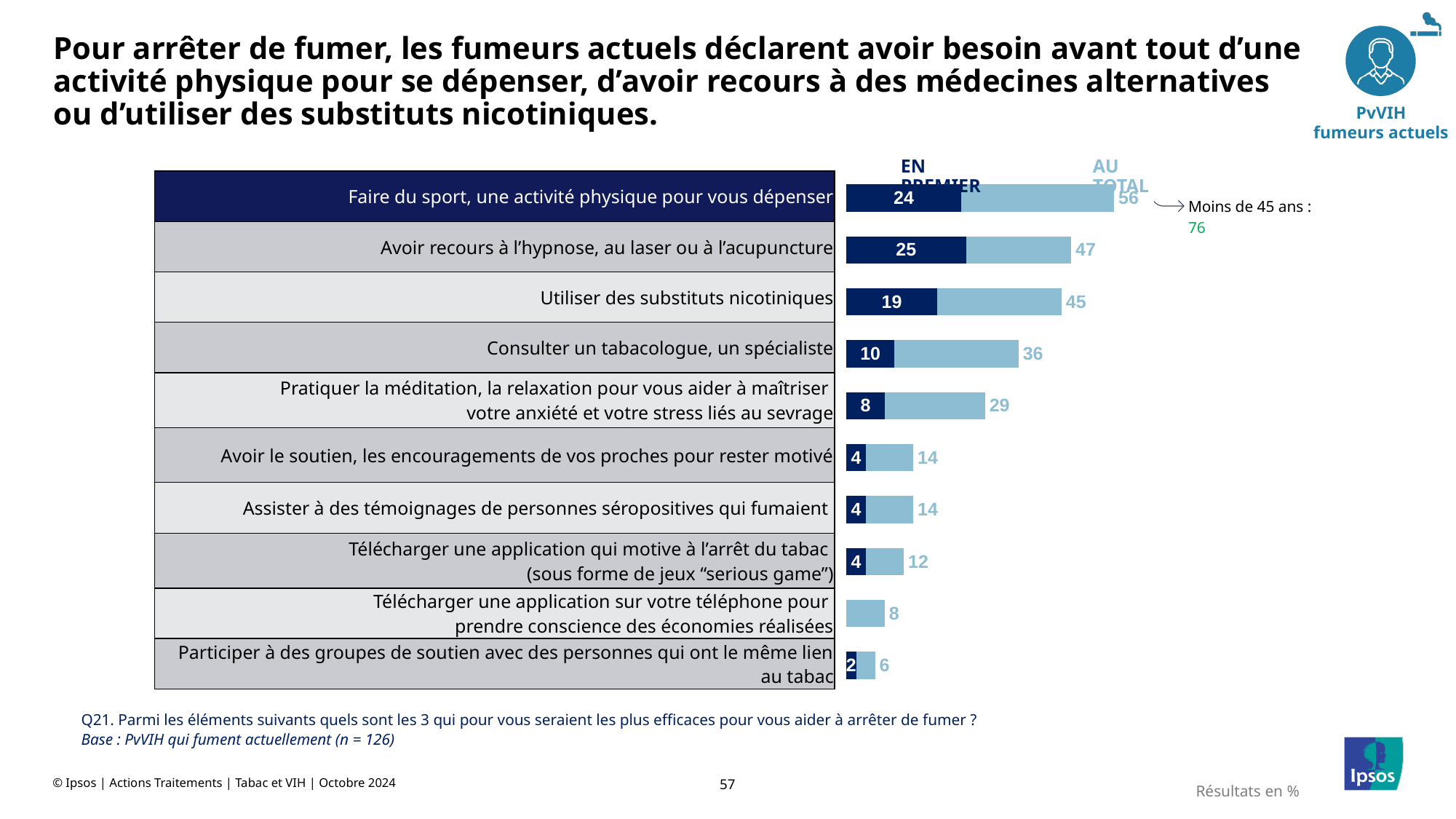
Which category has the lowest "AU TOTAL" value? Participer à des groupes de soutien avec des personnes qui ont le même lien au tabac Which category has the highest "AU TOTAL" value? Faire du sport, une activité physique pour vous dépenser What is the "AU TOTAL" value for "Pratiquer la méditation, la relaxation pour vous aider à maîtriser votre anxiété et votre stress liés au sevrage"? 29 What value is given for "Moins de 45 ans" next to the first bar? 76 Which has a larger "EN PREMIER" value: "Utiliser des substituts nicotiniques" or "Consulter un tabacologue, un spécialiste"? Utiliser des substituts nicotiniques How many categories are shown in the chart? 10 What is the difference between the "AU TOTAL" values for "Avoir recours à l'hypnose, au laser ou à l'acupuncture" and "Consulter un tabacologue, un spécialiste"? 11 What is the "EN PREMIER" value for "Avoir recours à l'hypnose, au laser ou à l'acupuncture"? 25 How many series does the chart show? 2 What is the "AU TOTAL" value for "Faire du sport, une activité physique pour vous dépenser"? 56 What is the "AU TOTAL" value for "Utiliser des substituts nicotiniques"? 45 What kind of chart is shown on the slide? Bar chart